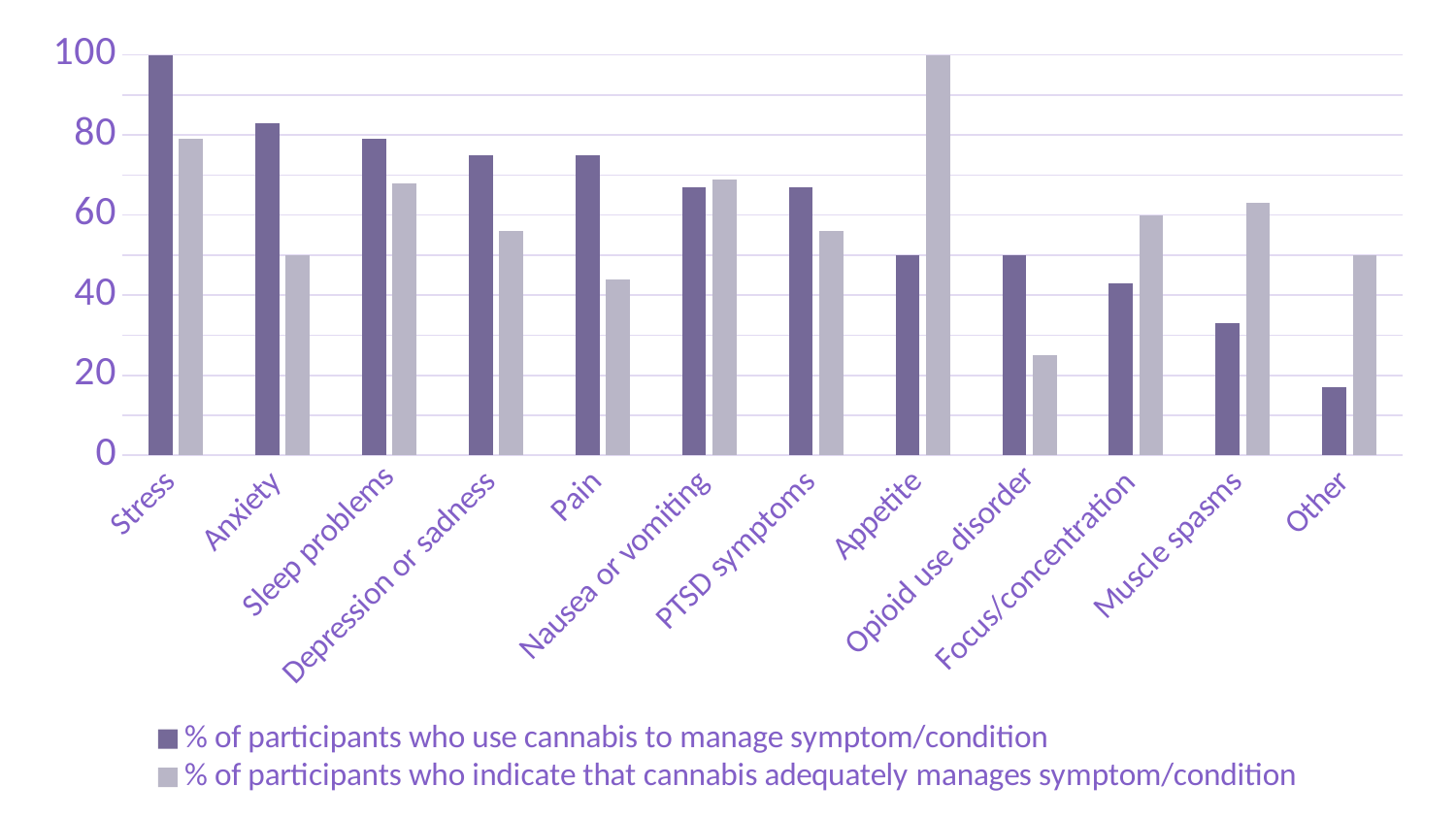
Which category has the lowest value for '% of participants who use cannabis to manage symptom/condition'? Other How many symptom/condition categories are shown on the x axis? 12 What is the value for Appetite in the '% of participants who indicate that cannabis adequately manages symptom/condition' series? 100 Which category has the highest value for '% of participants who indicate that cannabis adequately manages symptom/condition'? Appetite Which category has the highest value for '% of participants who use cannabis to manage symptom/condition'? Stress What is the value for Stress in the '% of participants who use cannabis to manage symptom/condition' series? 100 Which colour represents the '% of participants who use cannabis to manage symptom/condition' series? Dark purple What kind of chart is shown on the slide? Bar chart How many series does the legend list? 2 Is the value for Opioid use disorder in the '% of participants who indicate that cannabis adequately manages symptom/condition' series greater or less than 40? less For Muscle spasms, which series has the larger value: '% of participants who use cannabis to manage symptom/condition' or '% of participants who indicate that cannabis adequately manages symptom/condition'? % of participants who indicate that cannabis adequately manages symptom/condition Is the value for Anxiety in the '% of participants who use cannabis to manage symptom/condition' series greater or less than 80? greater